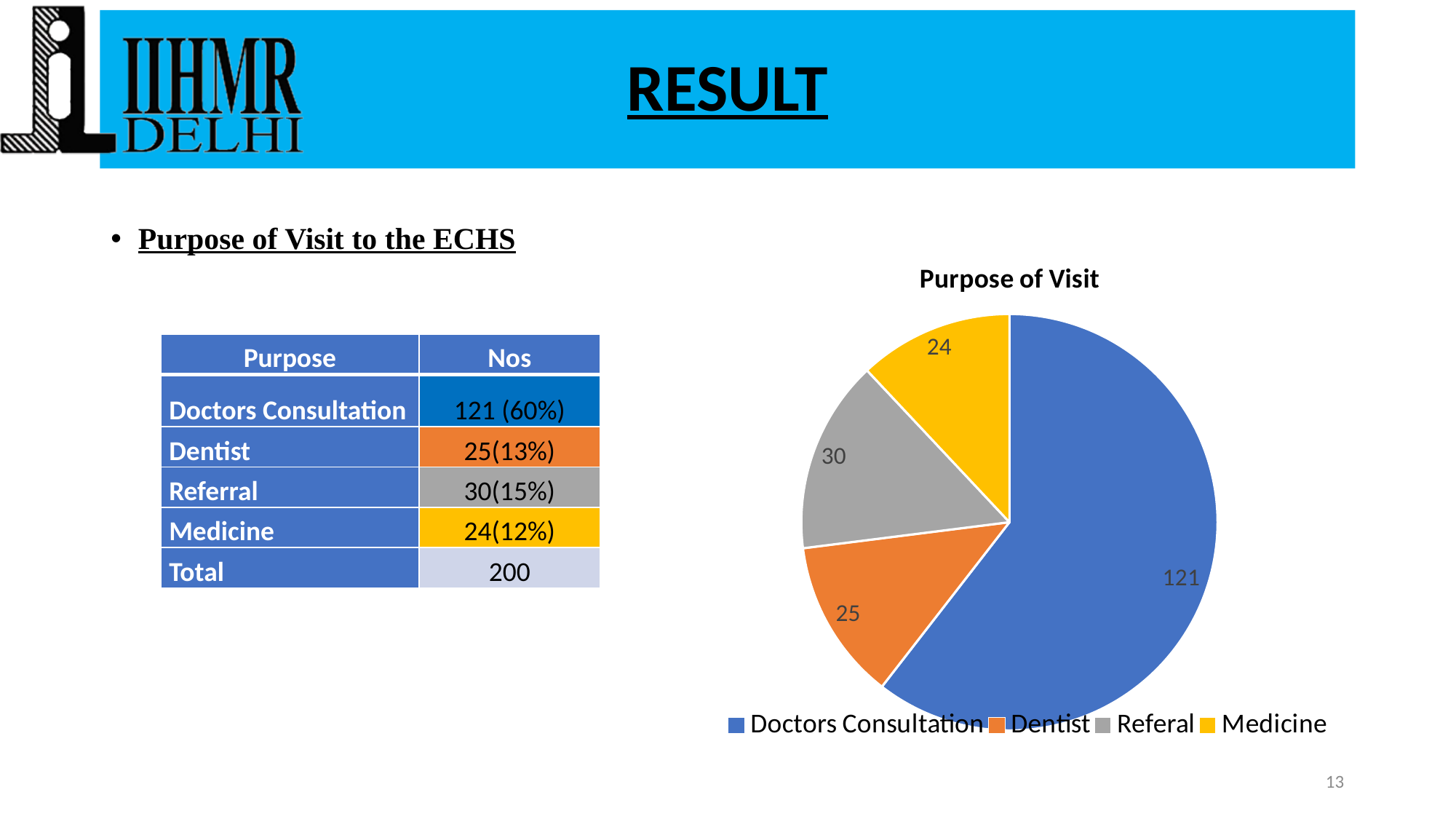
What is the title of the chart? Purpose of Visit Which is larger, the value for Referal or the value for Dentist? Referal What is the value for Doctors Consultation in the pie chart? 121 Which category has the smallest slice in the pie chart? Medicine What type of chart is shown on the slide? pie chart What is the value for Dentist in the pie chart? 25 What is the value for Medicine in the pie chart? 24 What is the difference between the values for Doctors Consultation and Referal? 91 What share of the pie does Doctors Consultation represent? 60% Which category has the largest slice in the pie chart? Doctors Consultation What is the value for Referal in the pie chart? 30 How many categories does the legend of the pie chart list? 4